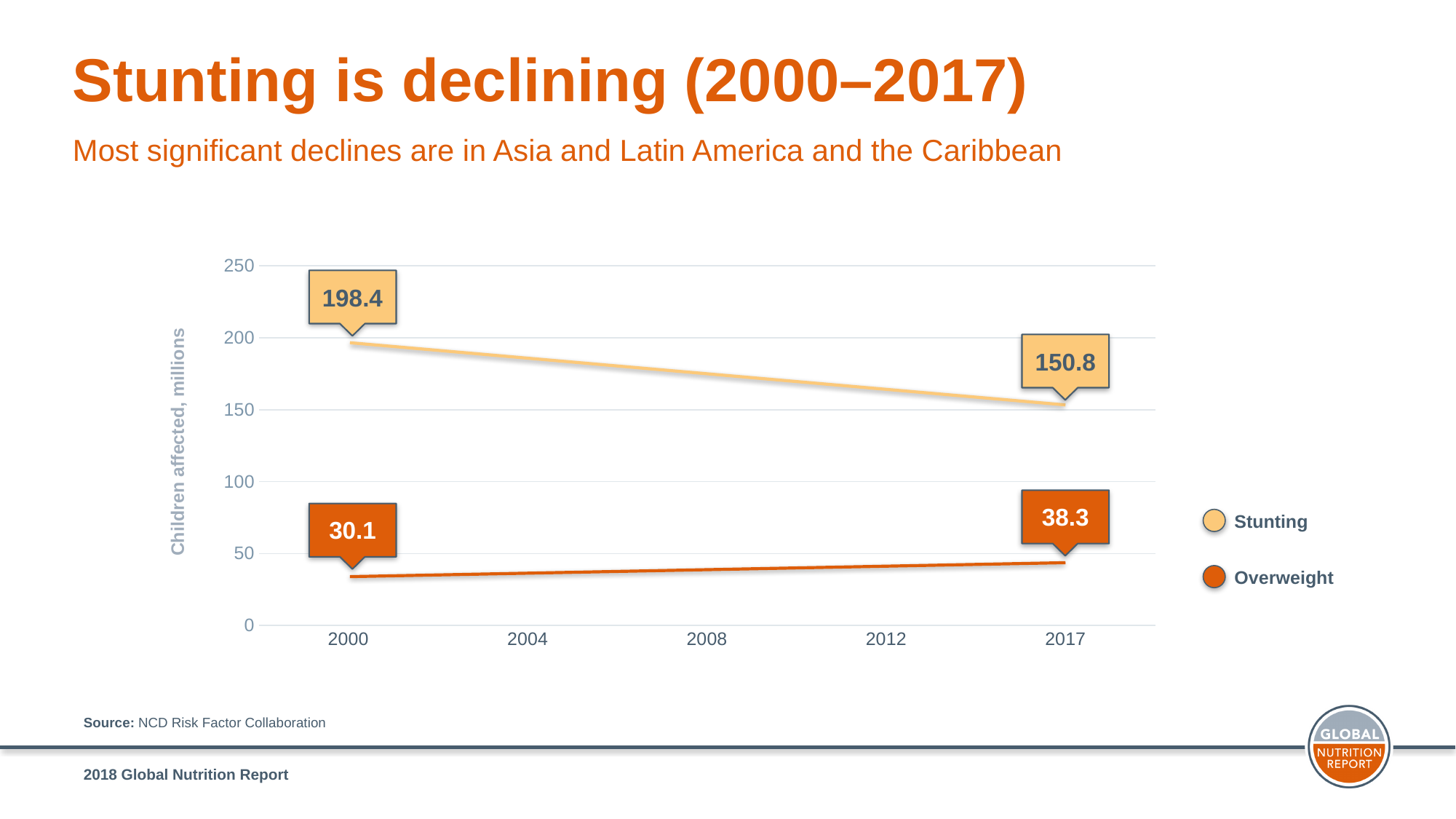
By how much did the Stunting value fall between 2000 and 2017? 47.6 What is the value for Stunting in 2017? 150.8 What is the value for Overweight in 2000? 30.1 Does the Stunting series rise or fall from 2000 to 2017? fall Which series has the higher value in 2017, Stunting or Overweight? Stunting What is the value for Overweight in 2017? 38.3 By how much did the Overweight value rise between 2000 and 2017? 8.2 What is the label of the vertical axis? Children affected, millions Does the Overweight series rise or fall from 2000 to 2017? rise What kind of chart is shown on the slide? line chart What is the value for Stunting in 2000? 198.4 How many series does the legend list? 2